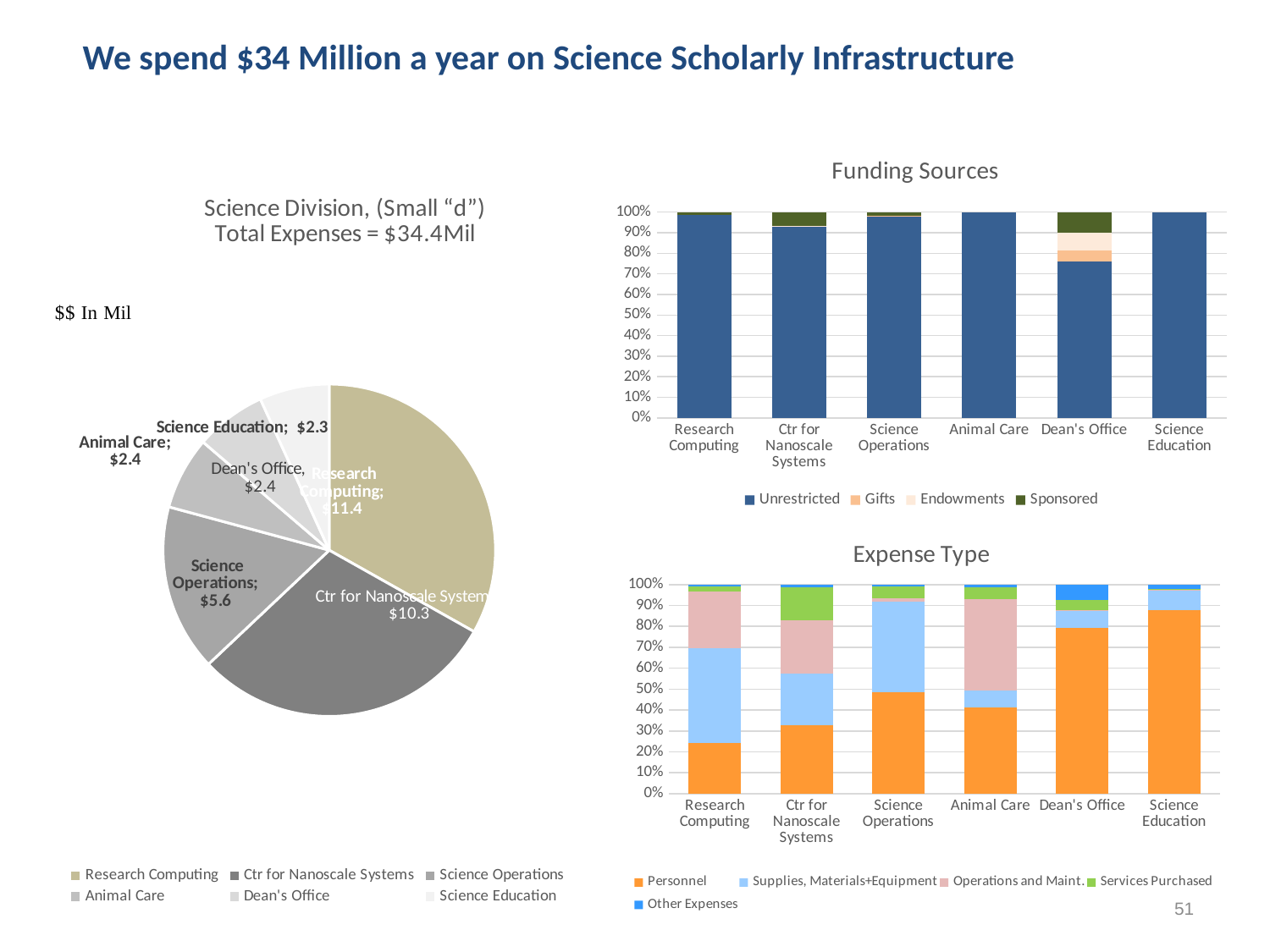
In the Funding Sources chart, is the Unrestricted value for Dean's Office greater or less than 80%? less In the Funding Sources chart, how many series does the legend list? 4 In the pie chart, which category has the largest slice? Research Computing In the pie chart, what is the value for Ctr for Nanoscale Systems? $10.3 In the pie chart, which category has the smallest slice? Science Education What kind of chart is the Science Division Total Expenses chart? Pie chart In the Expense Type chart, which has the larger Personnel share, Dean's Office or Research Computing? Dean's Office In the pie chart, how many categories are shown? 6 In the Expense Type chart, is the Personnel value for Research Computing greater or less than 30%? less In the pie chart, what is the value for Research Computing? $11.4 In the Expense Type chart, how many series does the legend list? 5 In the pie chart, what is the difference between Research Computing and Ctr for Nanoscale Systems? $1.1